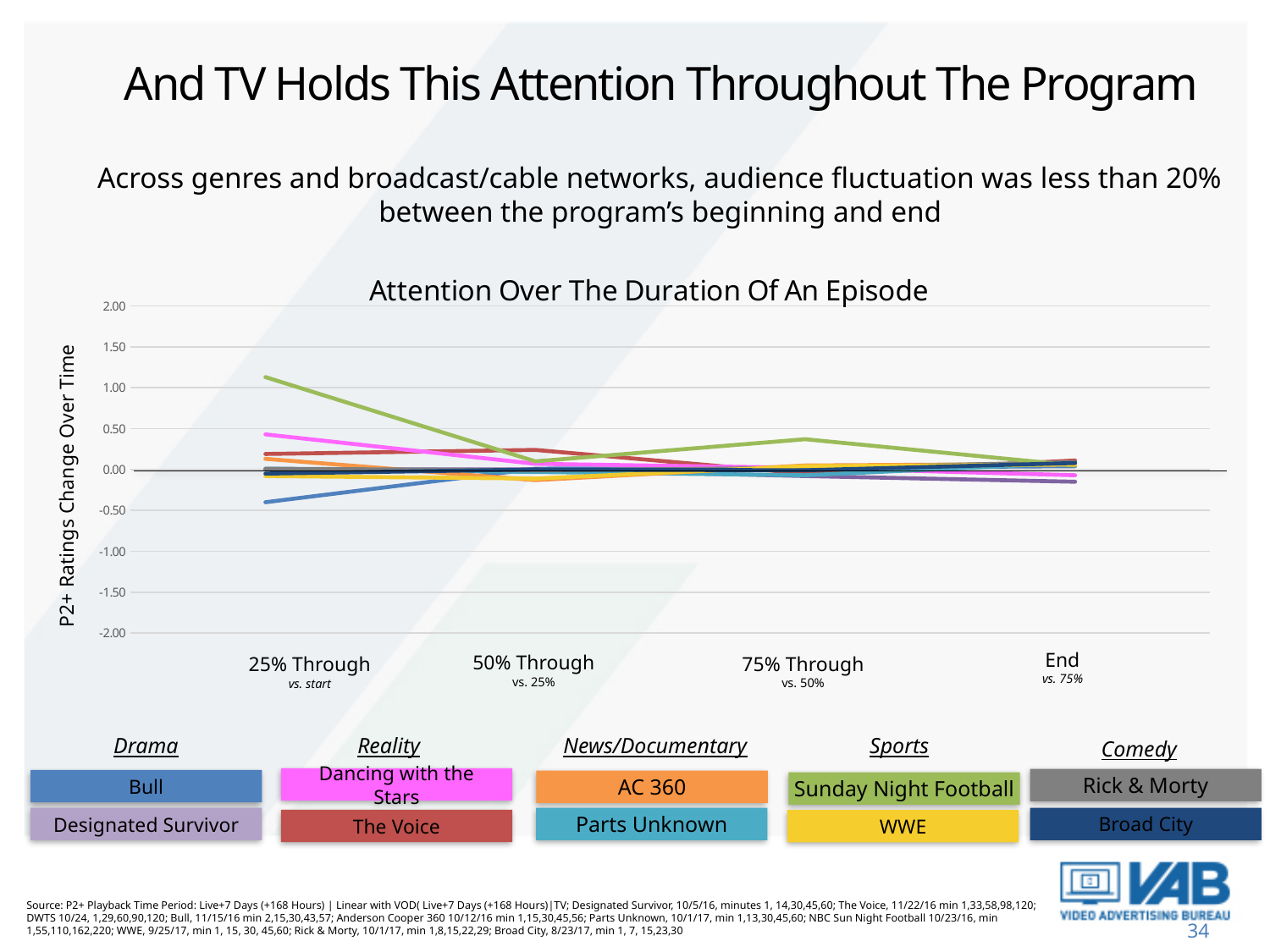
Is the value for Bull at 25% Through greater or less than 0.00? less How many programs does the legend list? 10 What is the title of the chart? Attention Over The Duration Of An Episode What is the label on the y axis of the chart? P2+ Ratings Change Over Time Is the value for Sunday Night Football at 25% Through greater or less than 0.50? greater Does the Sunday Night Football line rise or fall from 25% Through to 50% Through? fall Which program has the highest value at 25% Through? Sunday Night Football Which program has the lowest value at 25% Through? Bull What type of chart is shown on the slide? line chart How many points are there along the x axis of the chart? 4 At 25% Through, which is larger: the value for Sunday Night Football or the value for Dancing with the Stars? Sunday Night Football Does the Bull line rise or fall from 25% Through to End? rise